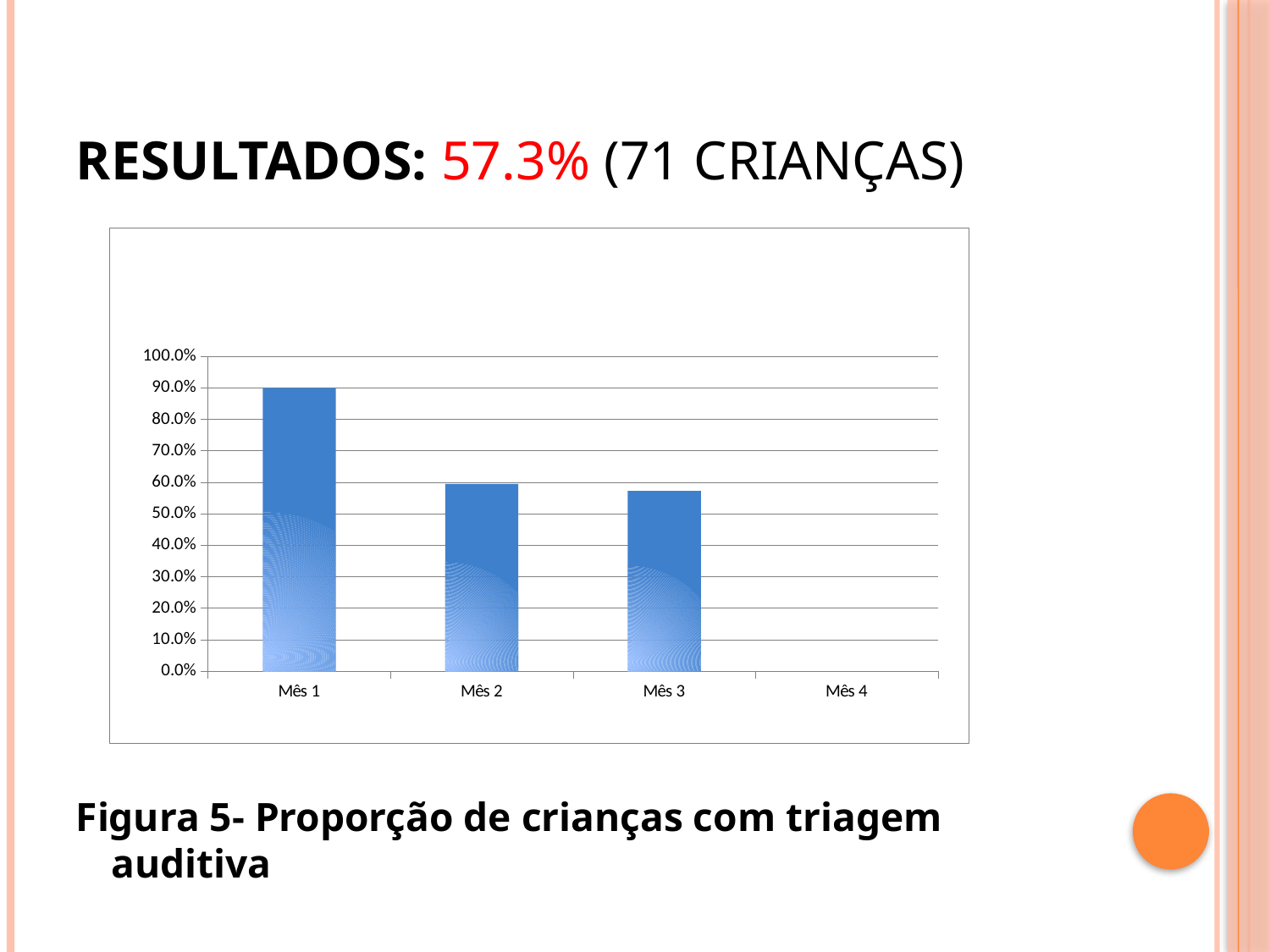
Do the bar values rise or fall from Mês 1 to Mês 3? fall Is the value for Mês 3 greater or less than 60.0%? less How many categories are shown on the x axis of the chart? 4 Is the value for Mês 1 greater or less than 80.0%? greater What is the highest value shown on the y axis of the chart? 100.0% Is the value for Mês 2 greater or less than 70.0%? less What is the value for Mês 1 in the chart? 90.0% Which is larger, the value for Mês 1 or the value for Mês 3? Mês 1 Which month has the highest bar in the chart? Mês 1 What is the figure caption given below the chart? Figura 5- Proporção de crianças com triagem auditiva What kind of chart is shown on the slide? bar chart